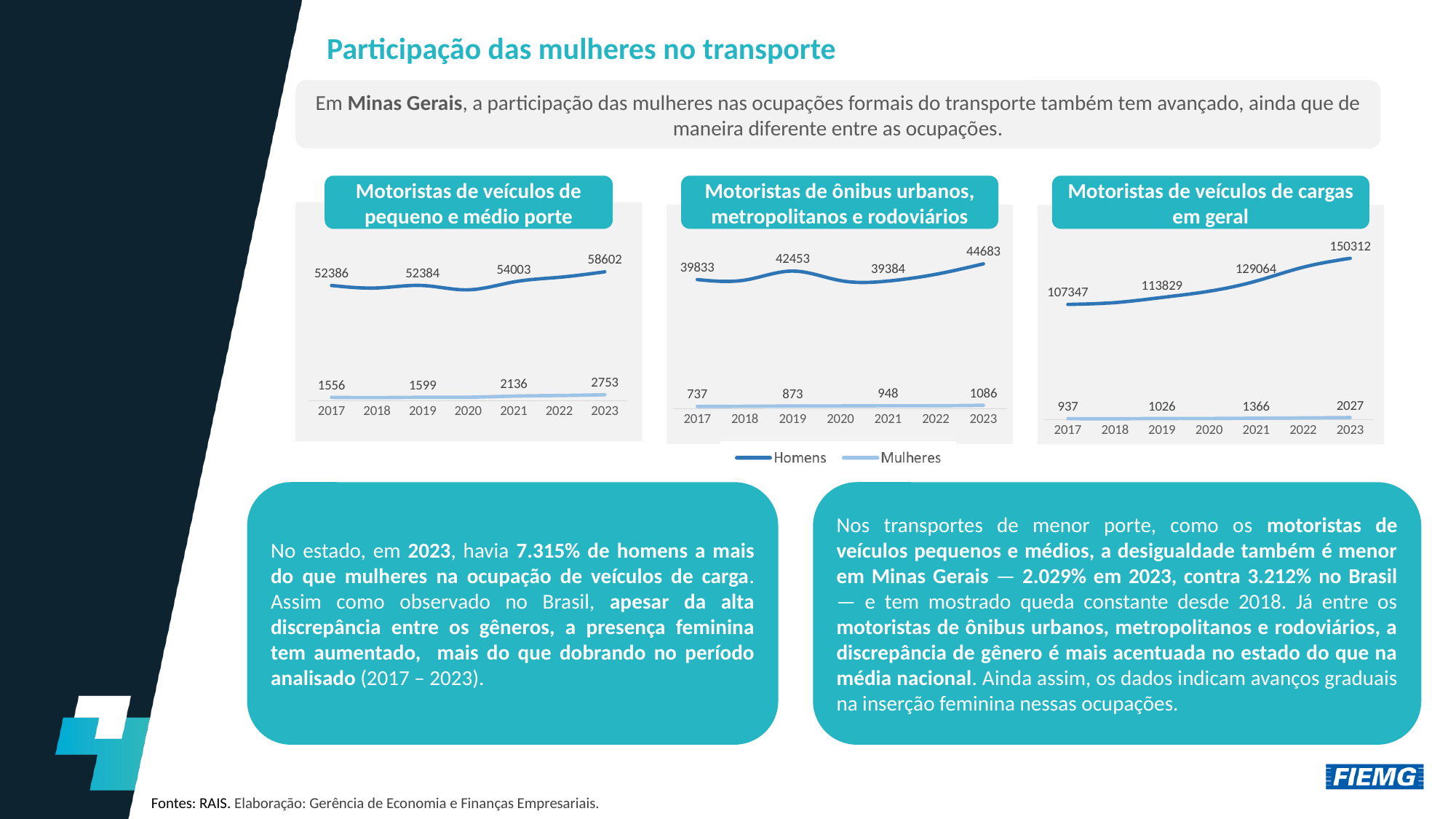
In the chart 'Motoristas de veículos de pequeno e médio porte', what is the value for Mulheres in 2017? 1556 In the chart 'Motoristas de ônibus urbanos, metropolitanos e rodoviários', is the Homens value higher in 2019 or in 2021? 2019 In the chart 'Motoristas de veículos de cargas em geral', what is the value for Homens in 2023? 150312 In the chart 'Motoristas de veículos de cargas em geral', which labelled year has the lowest value for Mulheres? 2017 In the chart 'Motoristas de ônibus urbanos, metropolitanos e rodoviários', which labelled year has the highest value for Homens? 2023 In the chart 'Motoristas de veículos de cargas em geral', what is the difference between the Homens values in 2023 and 2021? 21248 How many years are shown on the x axis of the chart 'Motoristas de veículos de pequeno e médio porte'? 7 How many series does the shared legend below the charts list? 2 In the chart 'Motoristas de veículos de pequeno e médio porte', what is the difference between the Mulheres values in 2023 and 2017? 1197 In the chart 'Motoristas de ônibus urbanos, metropolitanos e rodoviários', what is the value for Homens in 2021? 39384 In the chart 'Motoristas de veículos de cargas em geral', does the Homens series rise or fall from 2017 to 2023? Rise What type of chart is 'Motoristas de veículos de cargas em geral'? Line chart